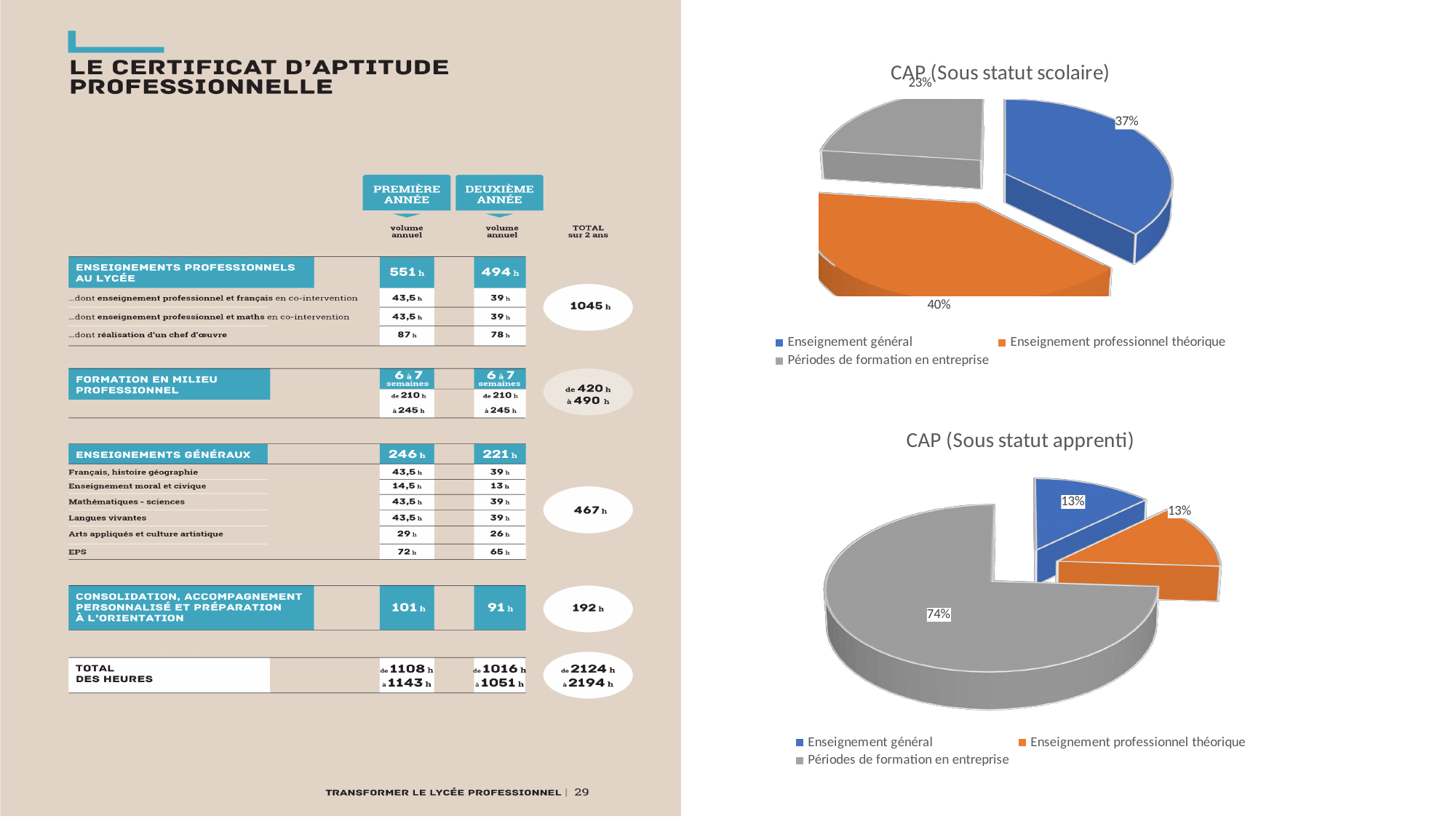
In the 'CAP (Sous statut apprenti)' chart, what share does 'Périodes de formation en entreprise' have? 74% In the 'CAP (Sous statut scolaire)' chart, what share does 'Enseignement général' have? 37% What type of chart is 'CAP (Sous statut scolaire)'? Pie chart Which chart gives 'Périodes de formation en entreprise' a larger share, 'CAP (Sous statut scolaire)' or 'CAP (Sous statut apprenti)'? CAP (Sous statut apprenti) In the 'CAP (Sous statut apprenti)' chart, what is the difference between the shares of 'Périodes de formation en entreprise' and 'Enseignement professionnel théorique'? 61% How many categories does the 'CAP (Sous statut apprenti)' chart's legend list? 3 In the 'CAP (Sous statut scolaire)' chart, what share does 'Périodes de formation en entreprise' have? 23% In the 'CAP (Sous statut scolaire)' chart, what is the difference between the shares of 'Enseignement professionnel théorique' and 'Périodes de formation en entreprise'? 17% In the 'CAP (Sous statut apprenti)' chart, what share does 'Enseignement général' have? 13% In the 'CAP (Sous statut apprenti)' chart, which category has the largest share? Périodes de formation en entreprise In the 'CAP (Sous statut scolaire)' chart, which category has the smallest share? Périodes de formation en entreprise In the 'CAP (Sous statut scolaire)' chart, what share does 'Enseignement professionnel théorique' have? 40%